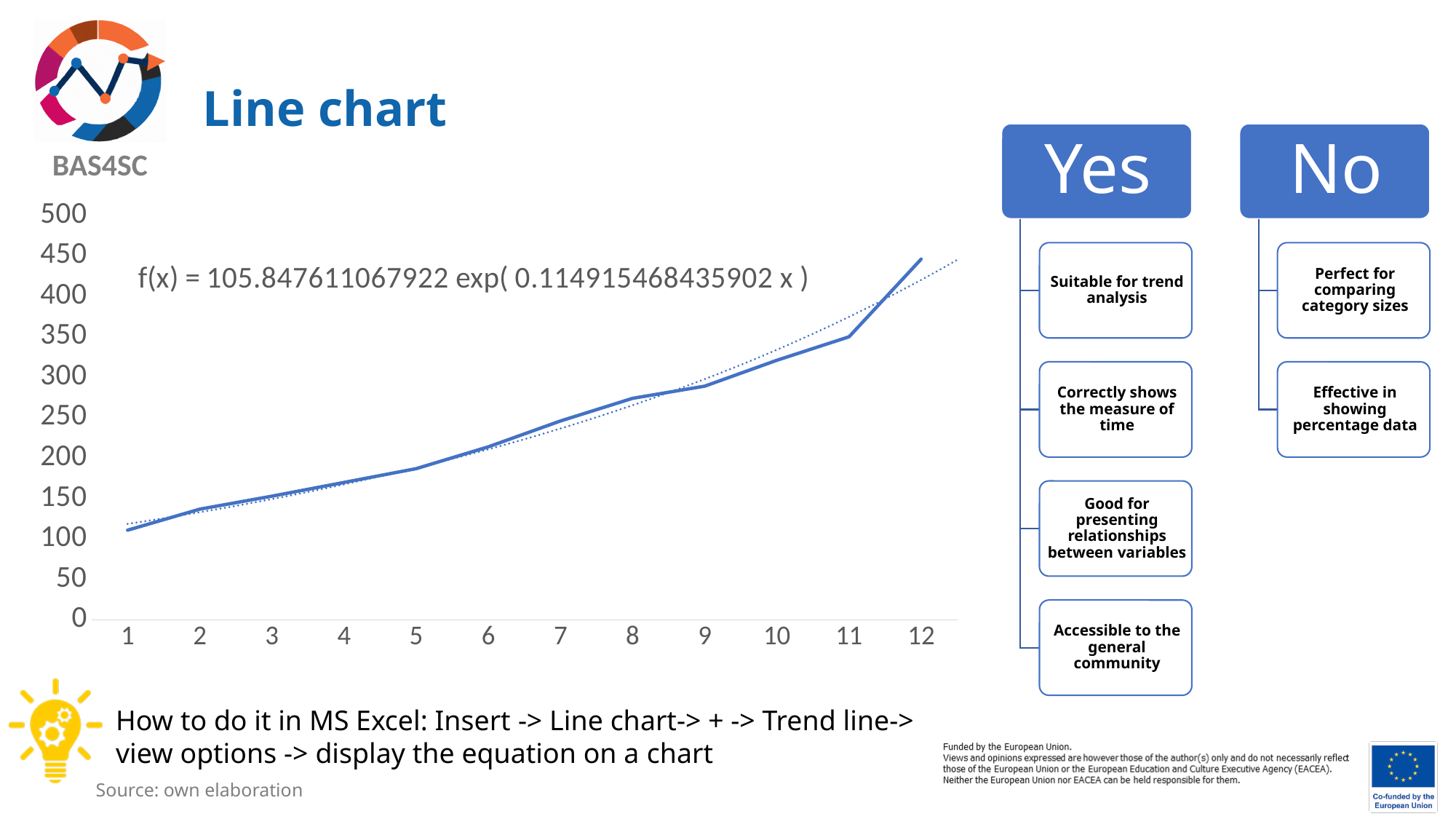
Which has the larger value in the line chart, x = 3 or x = 9? x = 9 Is the value at x = 6 greater or less than 250? less What is the trend line equation displayed on the chart? f(x) = 105.847611067922 exp( 0.114915468435902 x ) How many points are plotted along the x axis of the line chart? 12 Is the value at x = 12 greater or less than 400? greater At which x value does the line chart have its lowest value? 1 What kind of chart is shown on the slide? line chart What is the highest tick value shown on the y axis of the chart? 500 Do the values in the line chart rise or fall as x increases from 1 to 12? rise Is the value at x = 11 greater or less than 300? greater At which x value does the line chart reach its highest value? 12